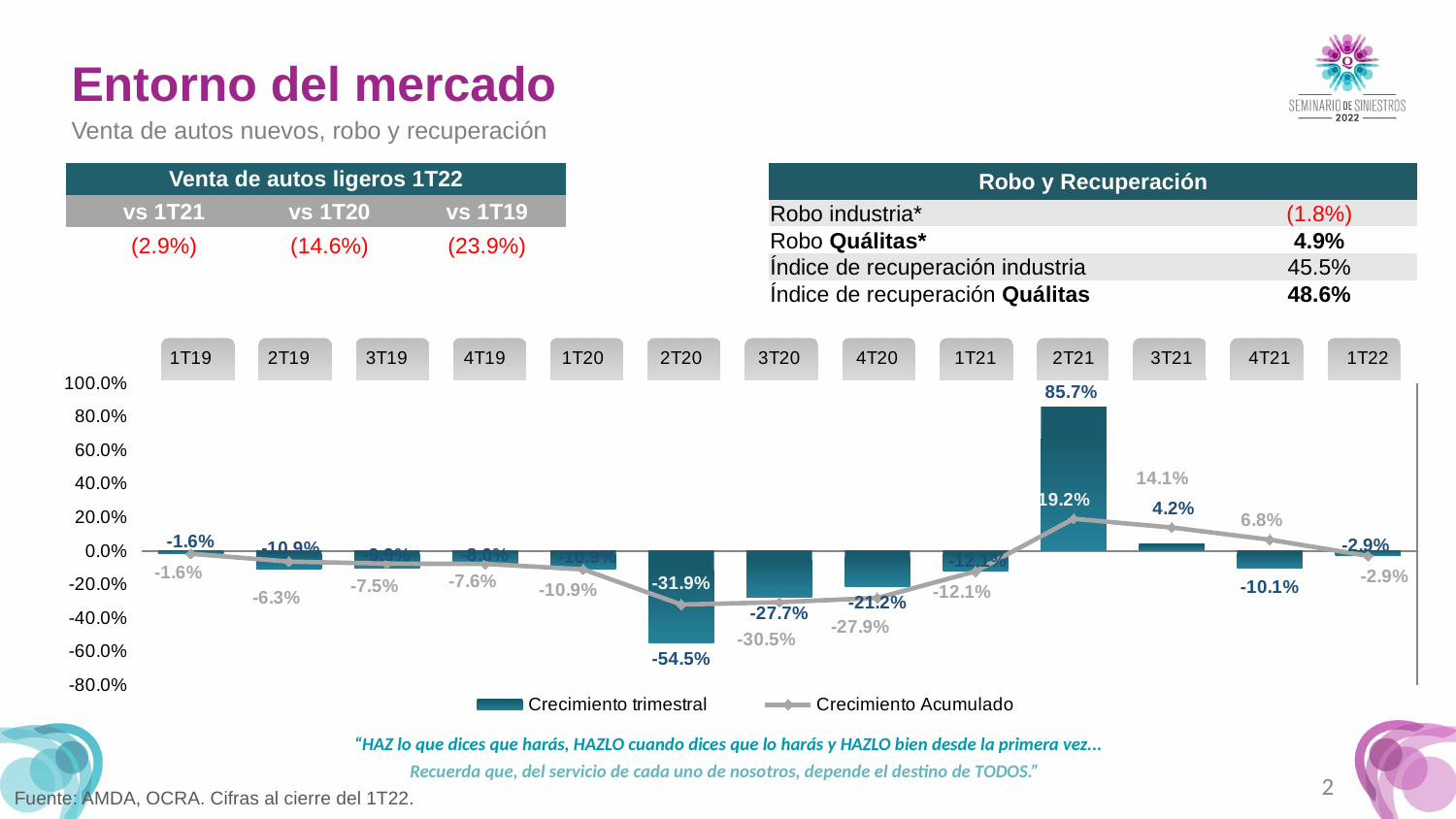
What is the Crecimiento Acumulado value for 2T20? -31.9% How many series does the chart legend list? 2 What is the Crecimiento trimestral value for 2T20? -54.5% What kind of chart is shown on the slide? A combined bar and line chart What is the Crecimiento Acumulado value for 4T21? 6.8% Which quarter has the lowest Crecimiento trimestral value? 2T20 Which is larger, the Crecimiento Acumulado value for 2T21 or for 3T21? 2T21 How many quarters (categories) are plotted along the x axis of the chart? 13 What are the two series named in the chart legend? Crecimiento trimestral and Crecimiento Acumulado What is the difference between the Crecimiento trimestral values for 3T20 (-27.7%) and 4T20 (-21.2%)? 6.5 percentage points Which quarter has the highest Crecimiento trimestral value? 2T21 What is the Crecimiento trimestral value for 2T21? 85.7%